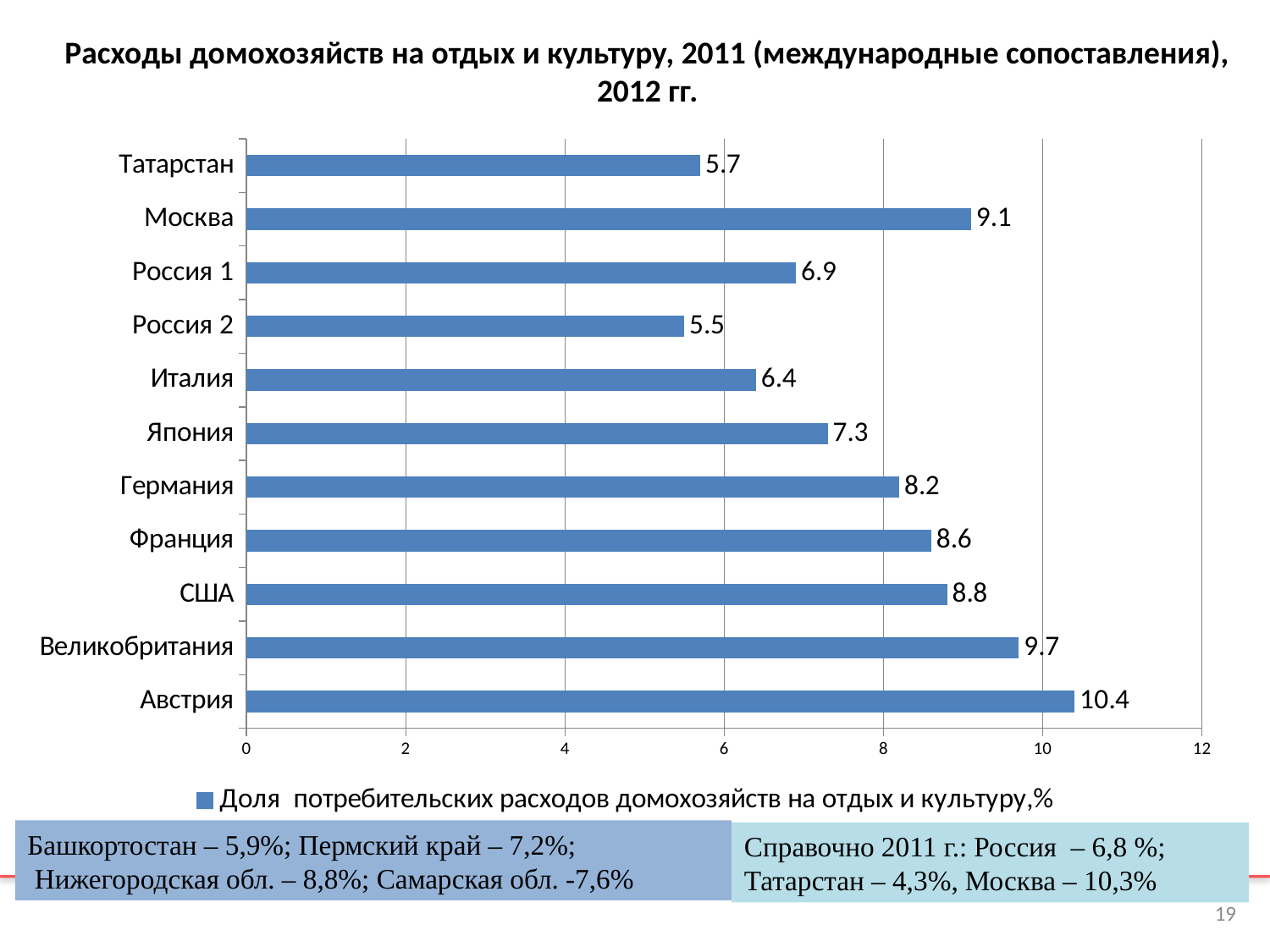
How many series does the legend list? 1 What is the value for Япония? 7.3 Which category has the lowest value? Россия 2 What is the difference between the values for Австрия and Татарстан? 4.7 What is the value for Татарстан? 5.7 What kind of chart is shown on the slide? bar chart Which category has the highest value? Австрия Is the value for Великобритания greater or less than 8? greater What is the legend entry of the chart? Доля потребительских расходов домохозяйств на отдых и культуру,% How many categories are shown in the chart? 11 Which is larger, the value for Германия or the value for Франция? Франция What is the value for Москва? 9.1